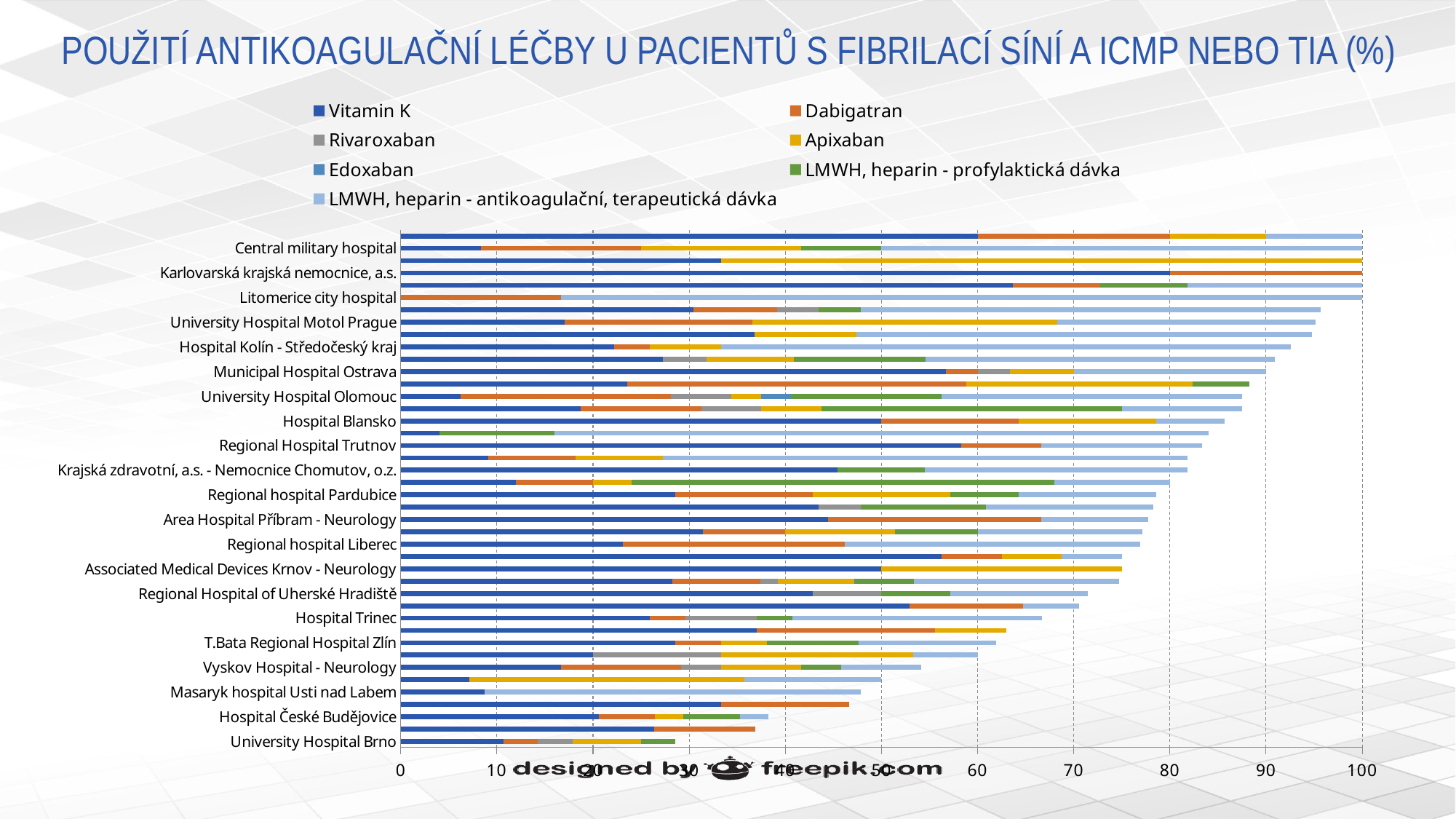
What kind of chart is shown on the slide? Stacked bar chart Is the total bar length for University Hospital Motol Prague greater or less than 90? greater Which has the longer total bar: Karlovarská krajská nemocnice, a.s. or University Hospital Brno? Karlovarská krajská nemocnice, a.s. What is the title of the chart? POUŽITÍ ANTIKOAGULAČNÍ LÉČBY U PACIENTŮ S FIBRILACÍ SÍNÍ A ICMP NEBO TIA (%) How many series does the legend list? 7 Which hospital has the shortest total bar in the chart? University Hospital Brno Is the total bar length for Hospital Trinec greater or less than 60? greater Which has the larger Vitamin K value: Karlovarská krajská nemocnice, a.s. or University Hospital Olomouc? Karlovarská krajská nemocnice, a.s. Is the total bar length for Hospital Blansko greater or less than 80? greater